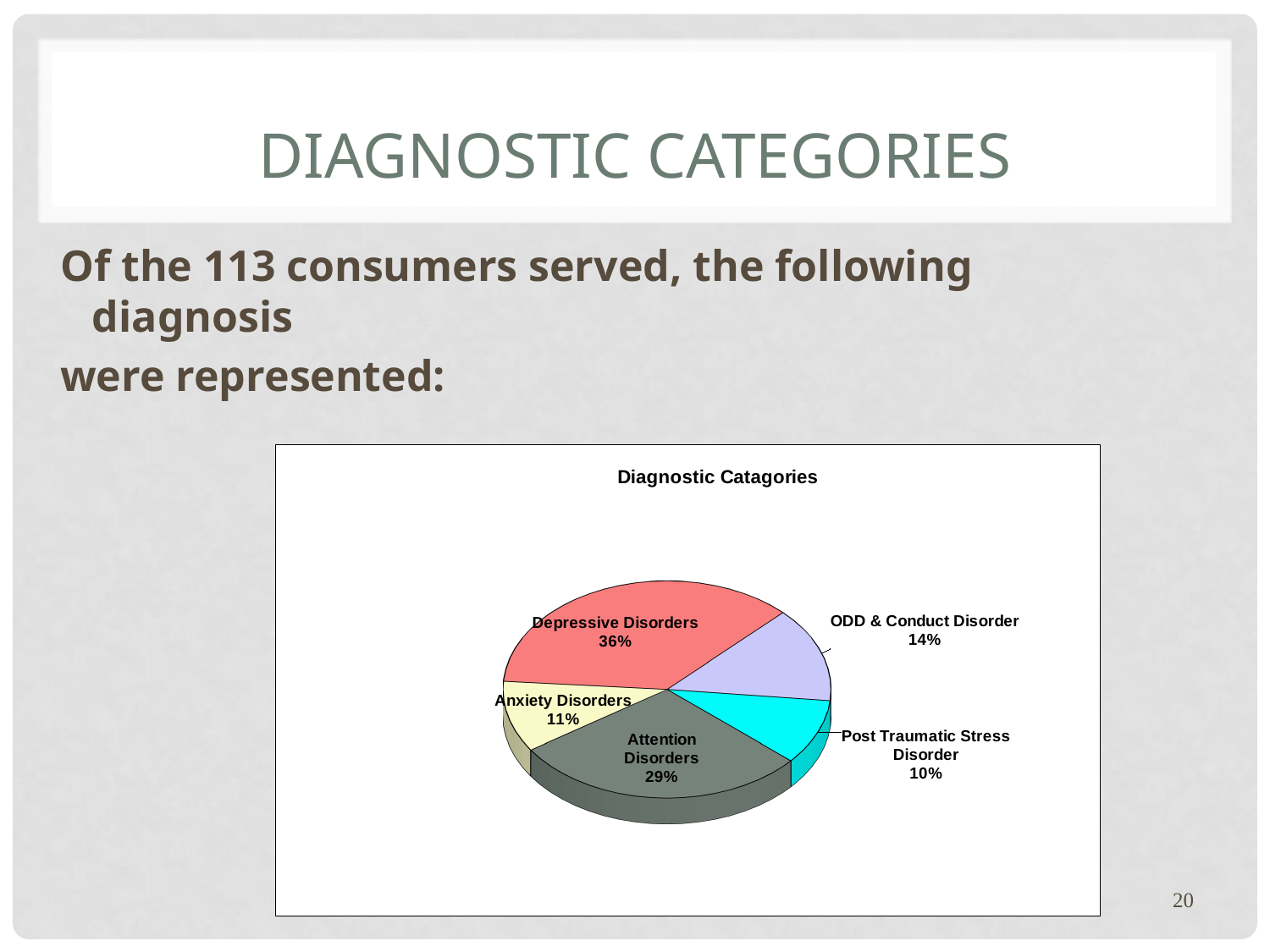
What is the title of the chart? Diagnostic Catagories What percentage of the pie is Attention Disorders? 29% What is the difference in percentage points between Depressive Disorders and Attention Disorders? 7 How many diagnostic categories are shown in the pie chart? 5 What kind of chart is shown on the slide? Pie chart What colour is the Depressive Disorders slice? Red What percentage of the pie is Depressive Disorders? 36% Which diagnostic category has the largest share of the pie? Depressive Disorders Which diagnostic category has the smallest share of the pie? Post Traumatic Stress Disorder Which has a larger share, Anxiety Disorders or ODD & Conduct Disorder? ODD & Conduct Disorder What percentage of the pie is Post Traumatic Stress Disorder? 10% What percentage of the pie is ODD & Conduct Disorder? 14%